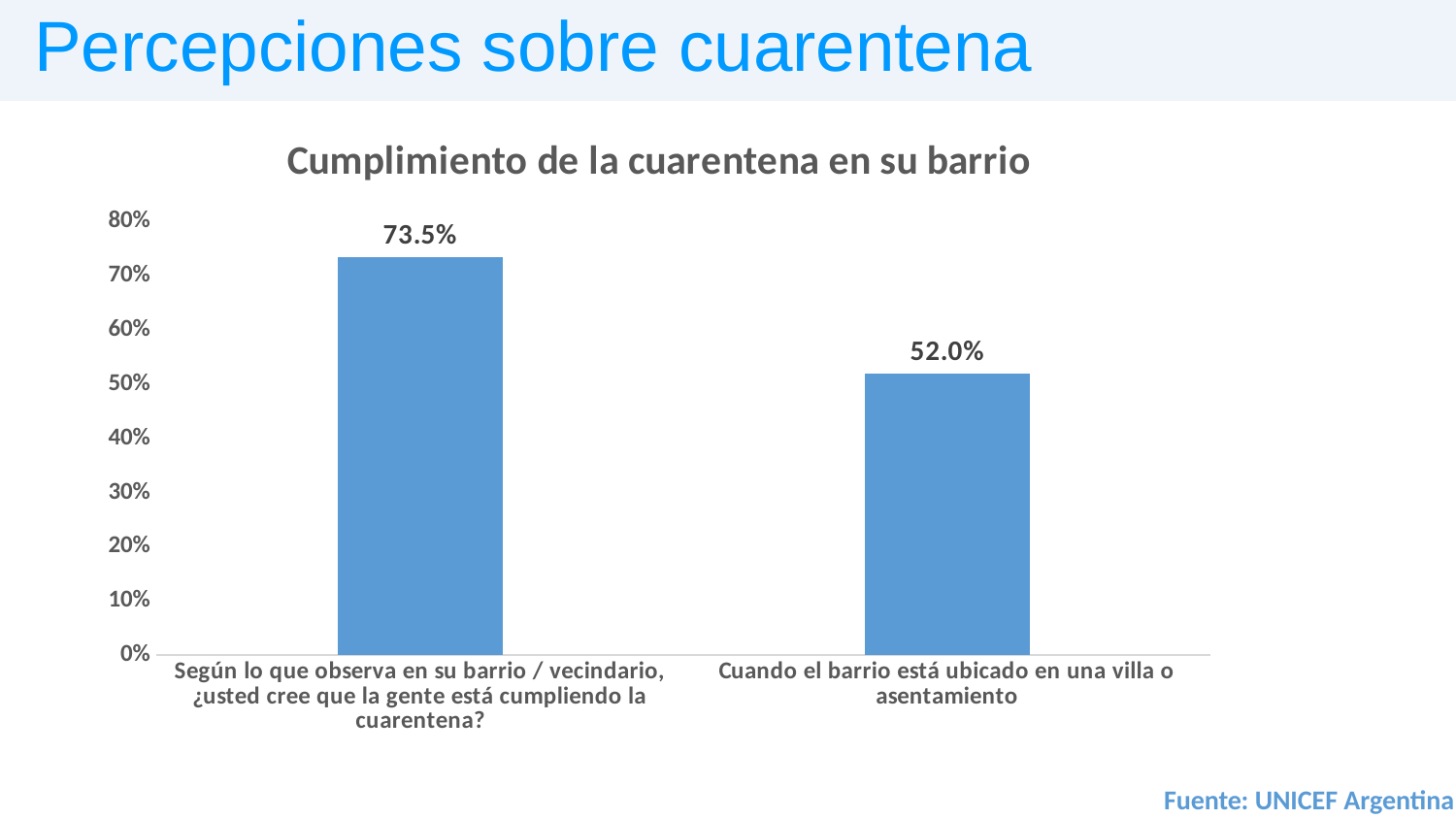
What is the value for "Según lo que observa en su barrio / vecindario, ¿usted cree que la gente está cumpliendo la cuarentena?"? 73.5% What is the difference between the two bars' values? 21.5% What is the source cited for the chart? UNICEF Argentina How many categories are shown in the chart? 2 What is the value for "Cuando el barrio está ubicado en una villa o asentamiento"? 52.0% Is the value for "Según lo que observa en su barrio / vecindario, ¿usted cree que la gente está cumpliendo la cuarentena?" greater or less than 70%? greater Which is larger: the value for the general neighbourhood question or the value for "Cuando el barrio está ubicado en una villa o asentamiento"? Según lo que observa en su barrio / vecindario, ¿usted cree que la gente está cumpliendo la cuarentena? Is the value for "Cuando el barrio está ubicado en una villa o asentamiento" greater or less than 60%? less Which category has the lowest value? Cuando el barrio está ubicado en una villa o asentamiento What kind of chart is shown on the slide? Bar chart What is the title of the chart? Cumplimiento de la cuarentena en su barrio Which category has the highest value? Según lo que observa en su barrio / vecindario, ¿usted cree que la gente está cumpliendo la cuarentena?